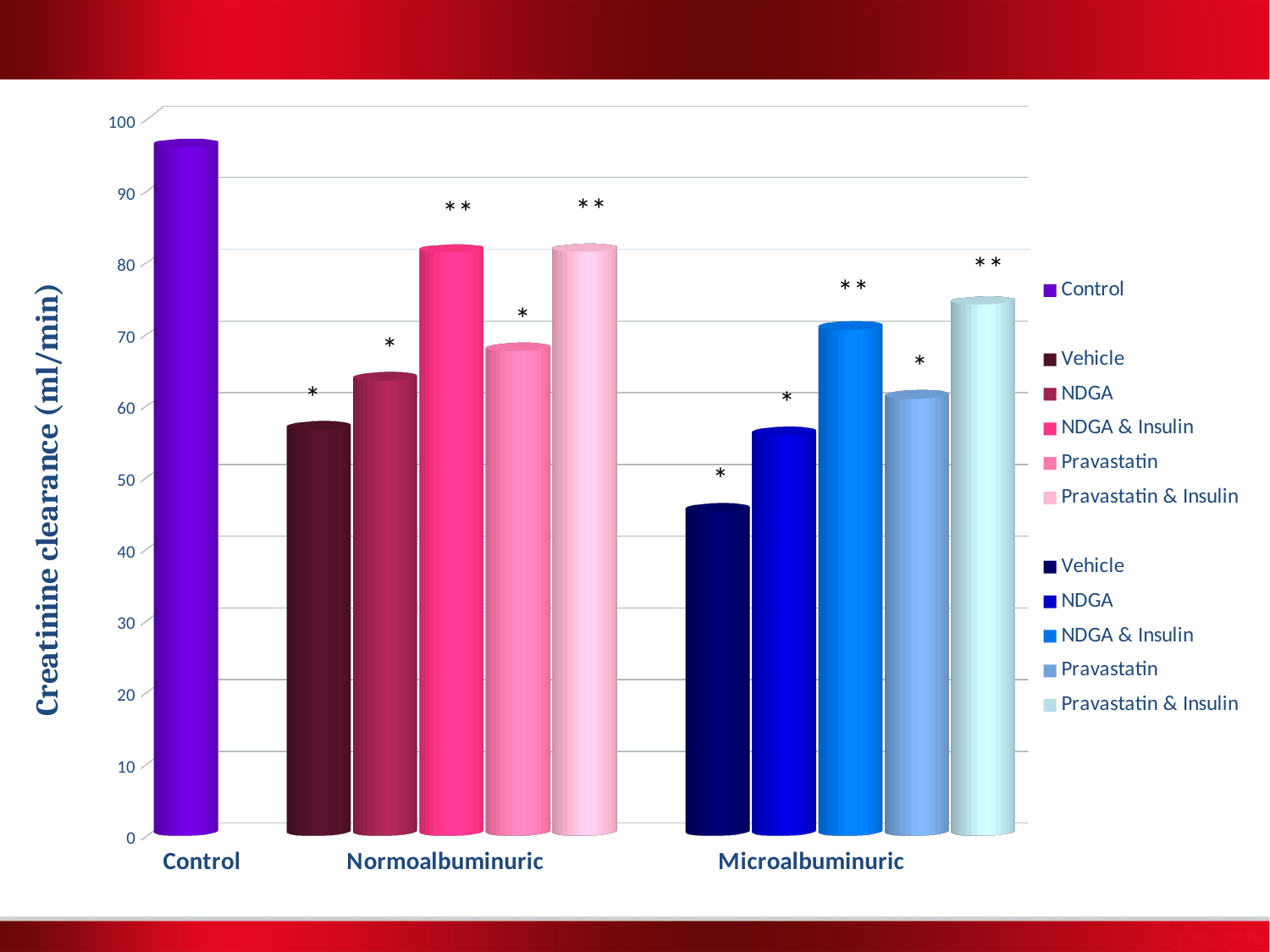
Is the value for NDGA & Insulin in the Normoalbuminuric group greater or less than 80? greater Which is larger, the Vehicle bar in the Normoalbuminuric group or the Vehicle bar in the Microalbuminuric group? Normoalbuminuric Vehicle Is the value for Pravastatin & Insulin in the Microalbuminuric group greater or less than 70? greater How many categories are shown on the x axis? 3 Is the value for Control greater or less than 90? greater How many series does the legend list? 11 What kind of chart is shown on the slide? bar chart Which bar is the lowest on the chart? Vehicle in the Microalbuminuric group Which bar is the highest on the chart? Control What is the title of the y axis? Creatinine clearance (ml/min)